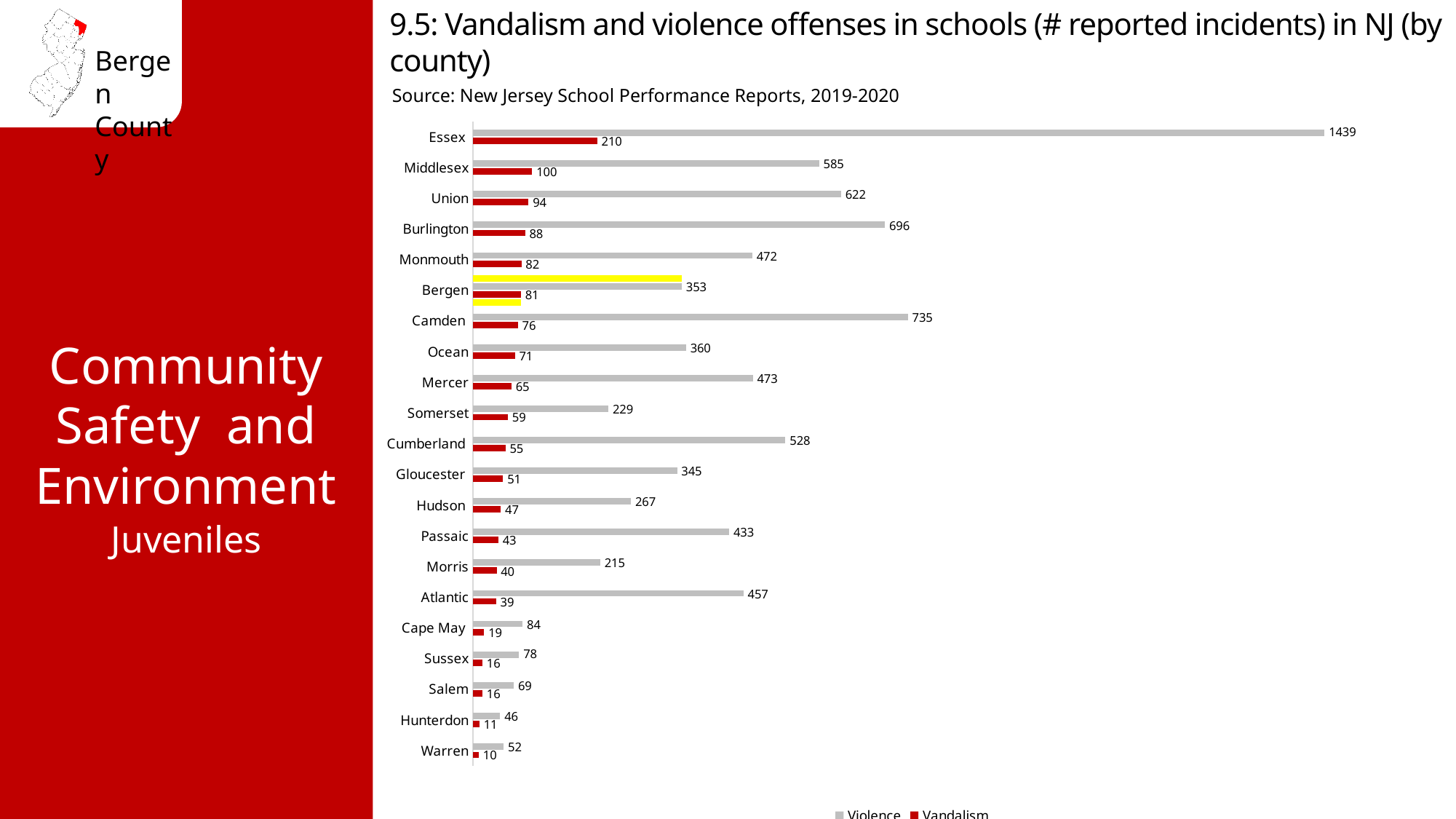
How many counties are shown on the chart? 21 Which county has the highest number of reported violence incidents? Essex What is the difference between the violence incidents for Camden and Burlington? 39 How many series does the legend list? 2 What is the number of reported vandalism incidents for Hunterdon? 11 What kind of chart is shown on the slide? Bar chart Which series is shown in red on the chart? Vandalism Which county has the lowest number of reported vandalism incidents? Warren Which county has more reported violence incidents, Union or Middlesex? Union What is the number of reported vandalism incidents for Essex? 210 What is the number of reported violence incidents for Bergen? 353 What is the difference between the vandalism incidents for Essex and Middlesex? 110